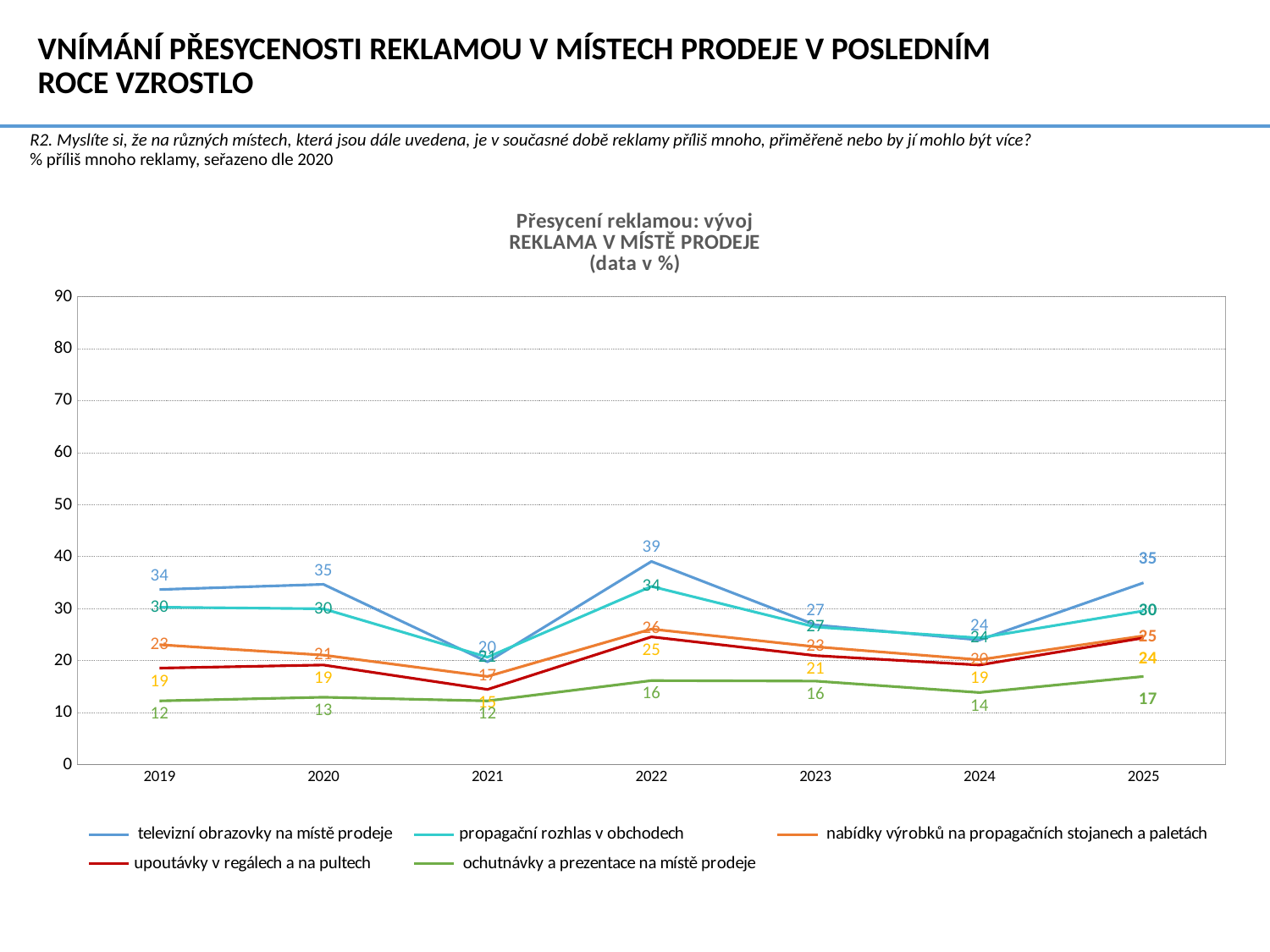
In which year does 'televizní obrazovky na místě prodeje' reach its highest value? 2022 What is the value for 'ochutnávky a prezentace na místě prodeje' in 2025? 17 How many series does the legend list? 5 In 2025, which is larger: 'televizní obrazovky na místě prodeje' or 'propagační rozhlas v obchodech'? televizní obrazovky na místě prodeje What is the value for 'televizní obrazovky na místě prodeje' in 2022? 39 How many years are plotted along the x axis? 7 What is the value for 'propagační rozhlas v obchodech' in 2022? 34 By how much did 'televizní obrazovky na místě prodeje' change from 2024 to 2025? 11 Does the value for 'televizní obrazovky na místě prodeje' rise or fall from 2024 to 2025? rise Which series has the lowest value in 2022? ochutnávky a prezentace na místě prodeje What kind of chart is shown on the slide? line chart What is the value for 'nabídky výrobků na propagačních stojanech a paletách' in 2025? 25